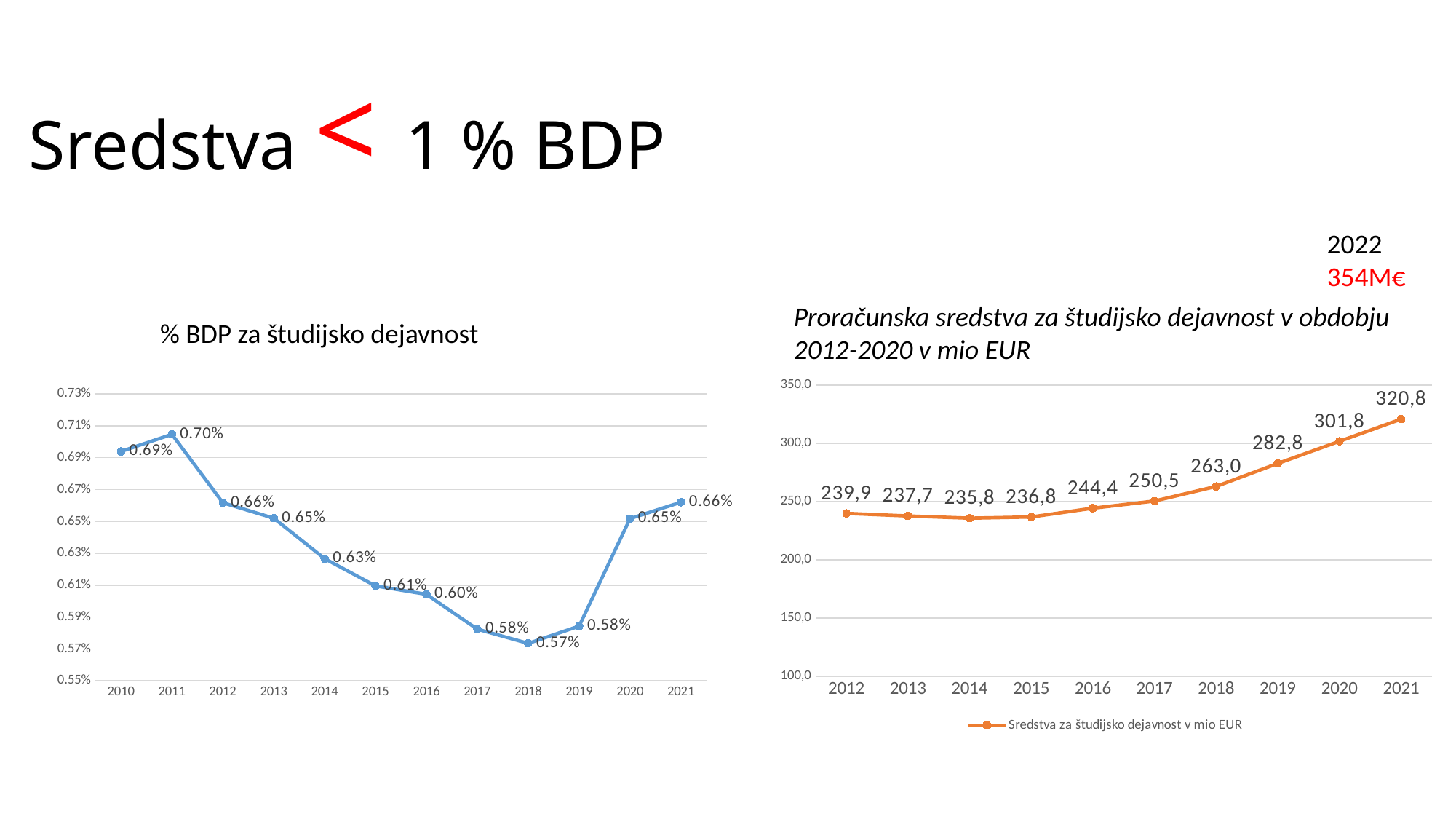
What kind of chart is the chart on the right ('Proračunska sredstva za študijsko dejavnost...')? Line chart In the chart titled '% BDP za študijsko dejavnost', which year has the lowest value? 2018 In the chart on the right ('Proračunska sredstva za študijsko dejavnost...'), is the value for 2018 larger than the value for 2016? Yes In the chart titled '% BDP za študijsko dejavnost', which year has the highest value? 2011 In the chart on the right ('Proračunska sredstva za študijsko dejavnost...'), which year has the lowest value? 2014 In the chart titled '% BDP za študijsko dejavnost', what is the value for 2018? 0.57% In the chart on the right ('Proračunska sredstva za študijsko dejavnost...'), what is the value for 2019? 282,8 In the chart titled '% BDP za študijsko dejavnost', how many years are plotted on the x axis? 12 In the chart titled '% BDP za študijsko dejavnost', what is the value for 2014? 0.63% In the chart on the right ('Proračunska sredstva za študijsko dejavnost...'), what is the difference between the values for 2021 and 2020? 19,0 In the chart on the right ('Proračunska sredstva za študijsko dejavnost...'), what series name does the legend show? Sredstva za študijsko dejavnost v mio EUR In the chart on the right ('Proračunska sredstva za študijsko dejavnost...'), which year has the highest value? 2021